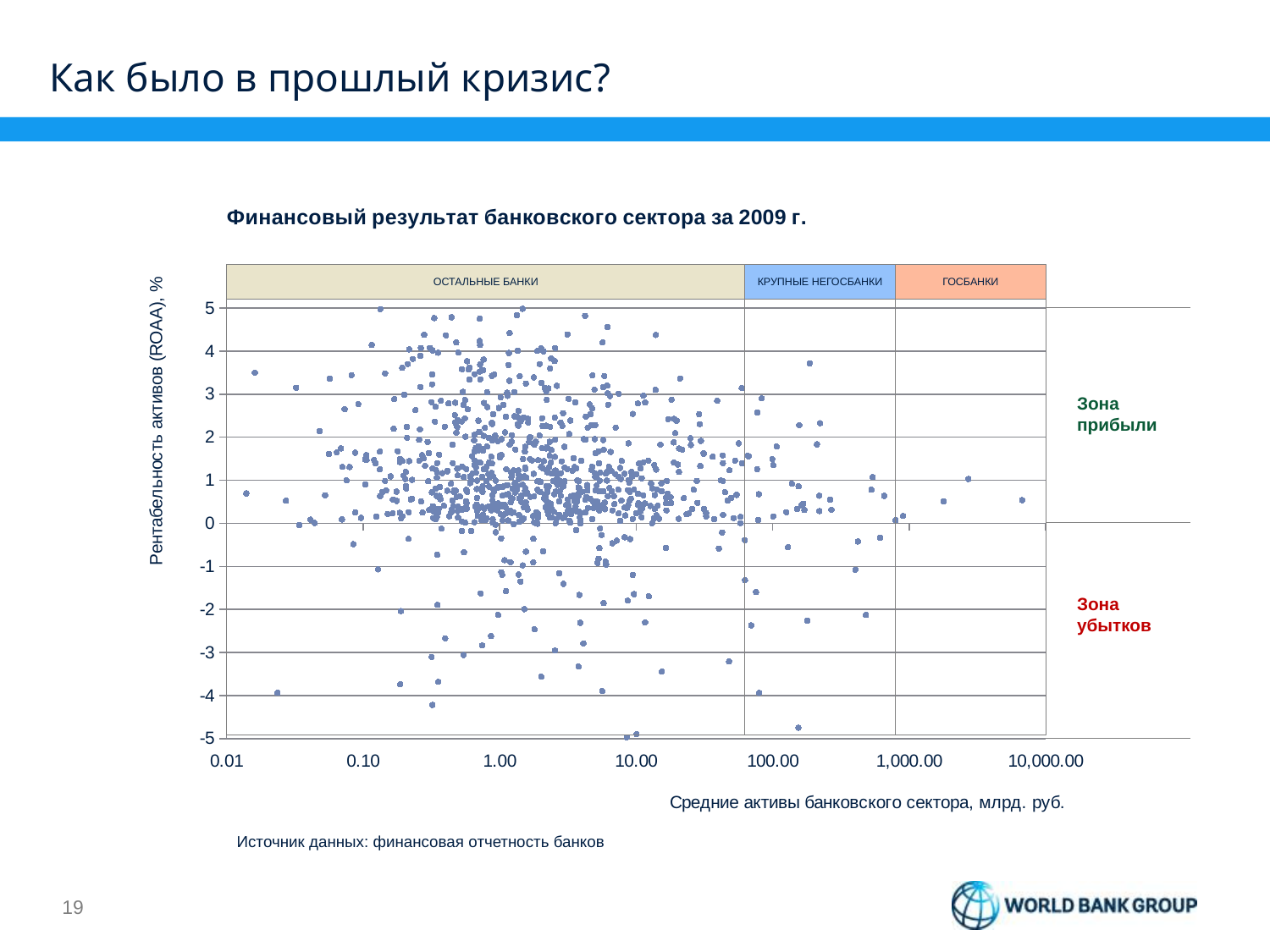
What is the lowest value shown on the vertical axis? -5 What is the largest value shown on the horizontal axis? 10,000.00 What is the highest value shown on the vertical axis? 5 What is the title of the chart? Финансовый результат банковского сектора за 2009 г. How many bank groups are marked along the top of the chart? 3 What are the two zones labelled to the right of the chart? Зона прибыли, Зона убытков Which bank group contains the fewest plotted points? ГОСБАНКИ Are the points in the ГОСБАНКИ group above or below 0 on the ROAA axis? above Which bank group contains the most plotted points? ОСТАЛЬНЫЕ БАНКИ What kind of chart is shown on the slide? scatter chart